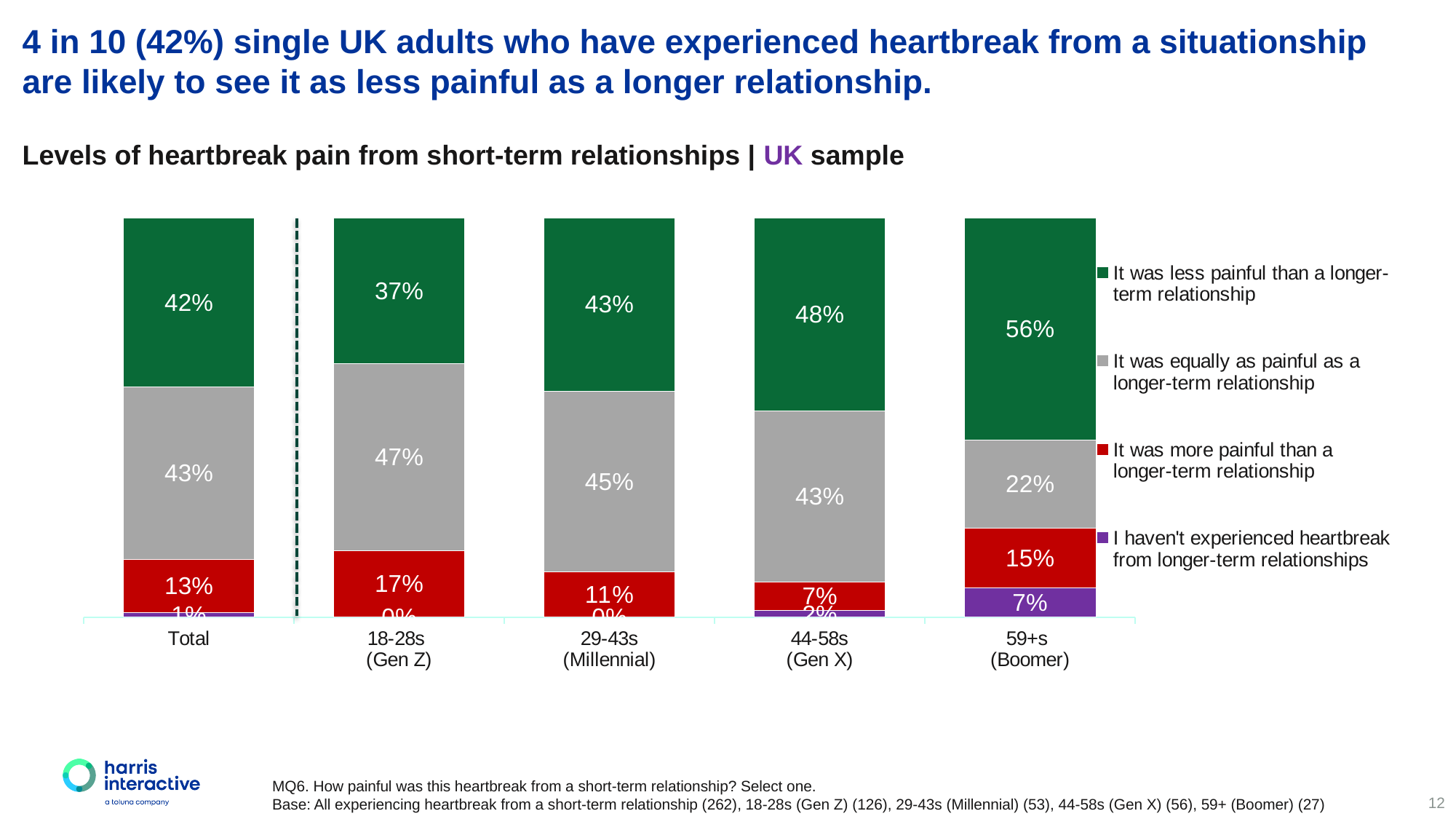
How many groups are shown along the x axis of the chart? 5 Moving from 18-28s (Gen Z) to 59+s (Boomer), does the share saying it was less painful than a longer-term relationship rise or fall? Rise How many percentage points higher is the 'less painful' share for 59+s (Boomer) than for 18-28s (Gen Z)? 19 percentage points What percentage of 29-43s (Millennial) said it was more painful than a longer-term relationship? 11% Which group has the highest share saying it was less painful than a longer-term relationship? 59+s (Boomer) Which group has the lowest share saying it was more painful than a longer-term relationship? 44-58s (Gen X) For 44-58s (Gen X), which is larger: the share saying it was less painful or the share saying it was equally as painful? Less painful (48%) What percentage of 59+s (Boomer) said it was less painful than a longer-term relationship? 56% What kind of chart is shown on the slide? Stacked bar chart What percentage of 18-28s (Gen Z) said it was equally as painful as a longer-term relationship? 47% How many series does the legend list? 4 What percentage of 59+s (Boomer) said they haven't experienced heartbreak from longer-term relationships? 7%